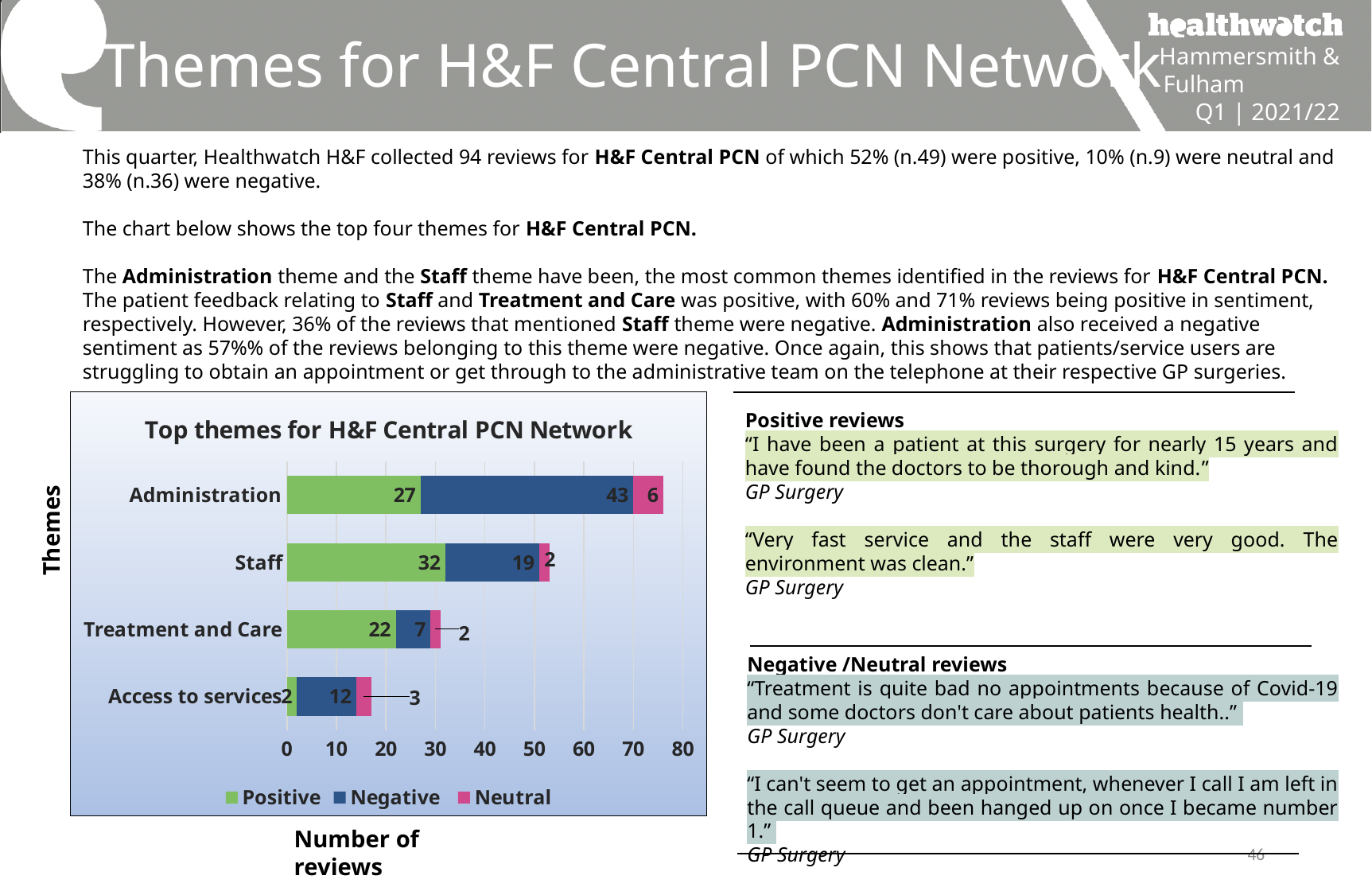
Which theme has the lowest Positive value? Access to services What is the Negative value for Staff? 19 How many themes (categories) are plotted in the chart? 4 Which is larger, the Positive value for Staff or the Positive value for Treatment and Care? Staff What is the Neutral value for Access to services? 3 What is the total number of reviews in the Staff bar? 53 What type of chart is shown on the slide? Stacked bar chart What is the title of the chart? Top themes for H&F Central PCN Network Which theme has the highest Negative value? Administration What is the difference between the Negative and Positive values for Administration? 16 How many series does the chart legend list? 3 What is the Positive value for Administration? 27